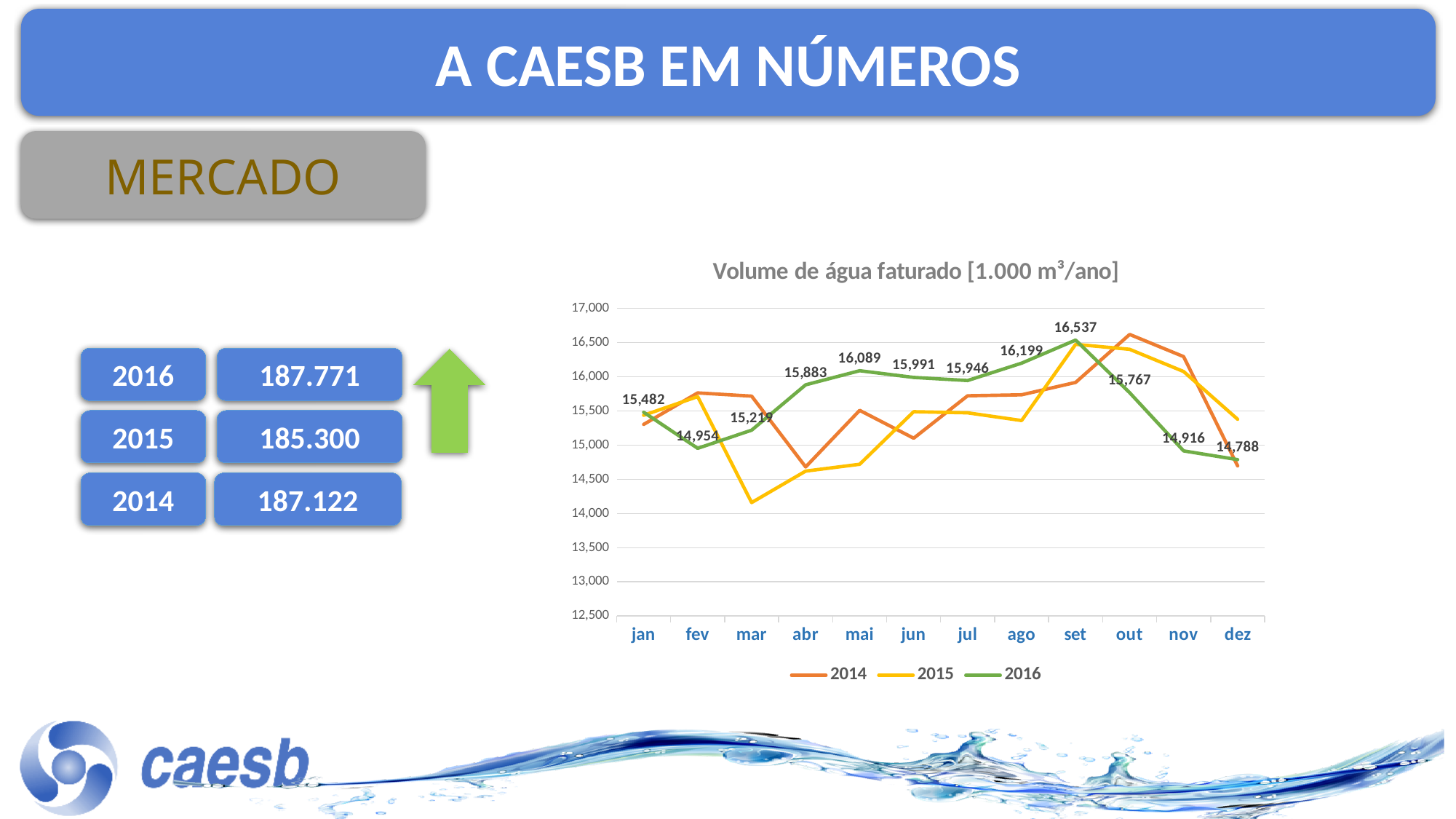
In which month does the 2016 series reach its highest value? set What is the title of the chart? Volume de água faturado [1.000 m³/ano] In which month does the 2016 series have its lowest value? dez What is the value for the 2016 series in dez? 14,788 What is the value for the 2016 series in set (September)? 16,537 For the 2016 series, which is larger: the value in mai or the value in jul? mai Is the value for the 2015 series in mar greater or less than 14,500? less What kind of chart is shown on the slide? line chart How many series does the chart legend list? 3 What is the difference between the 2016 values for set and out? 770 What is the value for the 2016 series in jan? 15,482 How many months are shown on the x axis of the chart? 12